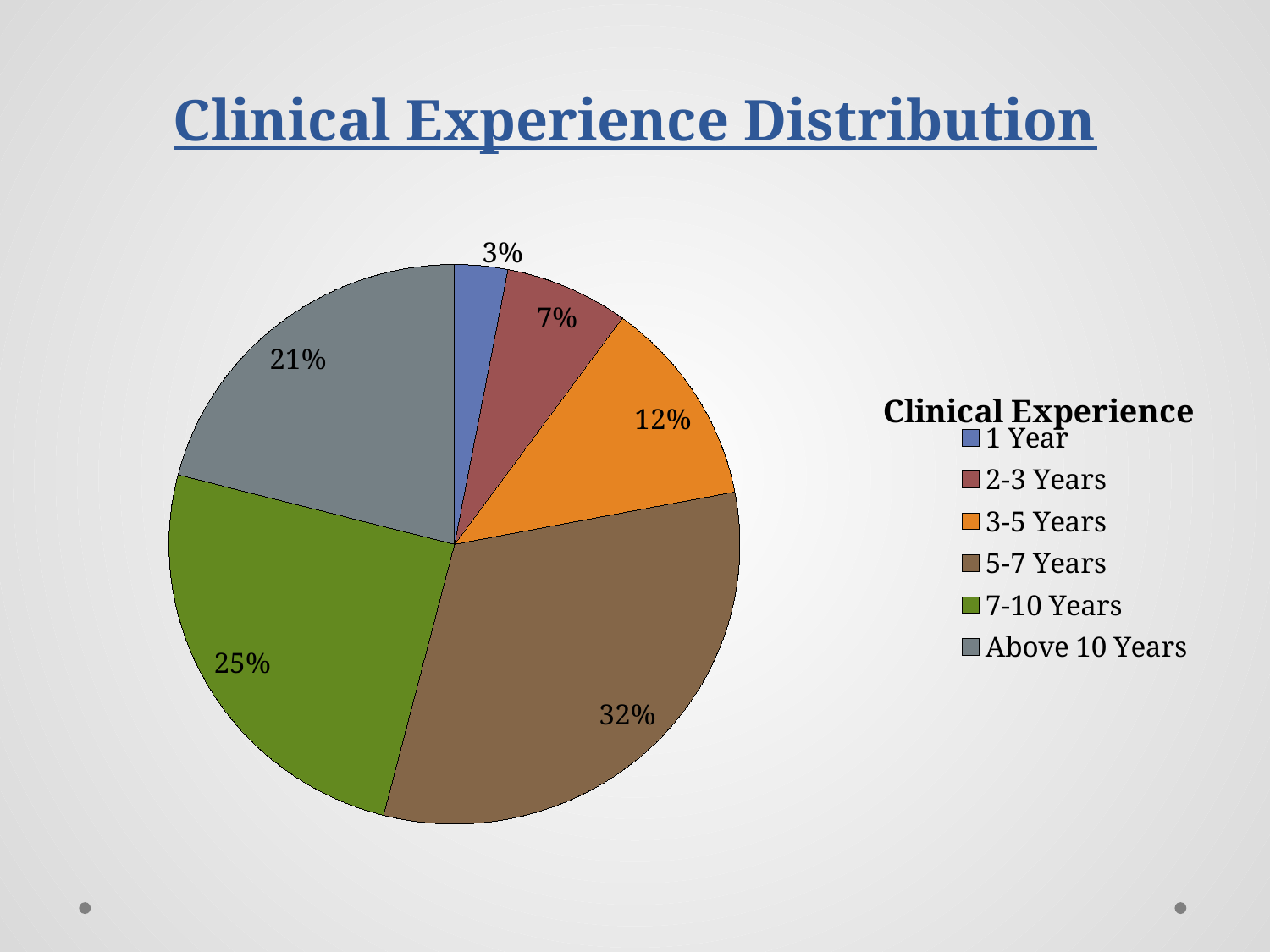
Which slice is larger, 7-10 Years or Above 10 Years? 7-10 Years What colour is the 3-5 Years slice? Orange How many categories does the pie chart have? 6 What percentage of the pie is the 5-7 Years slice? 32% What percentage of the pie is the Above 10 Years slice? 21% What kind of chart is shown on the slide? Pie chart What percentage of the pie is the 3-5 Years slice? 12% What percentage of the pie is the 1 Year slice? 3% What is the difference in percentage points between the 7-10 Years slice and the 2-3 Years slice? 18 What is the title of the chart's legend? Clinical Experience Which category has the largest share of the pie? 5-7 Years Which category has the smallest share of the pie? 1 Year